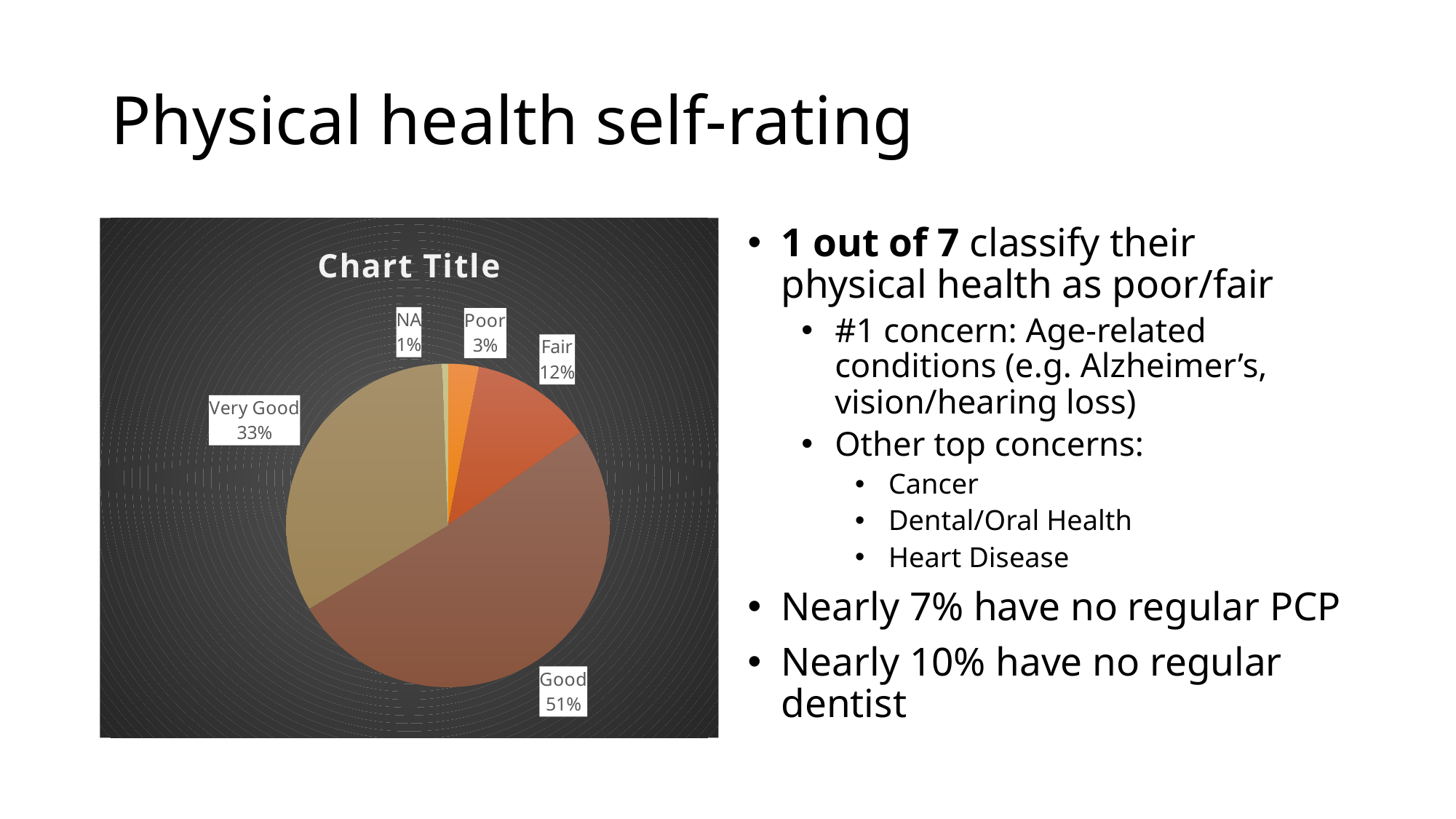
What share of the pie is labelled Good? 51% What is the title shown on the chart? Chart Title What share of the pie is labelled Very Good? 33% Which category has the smallest slice of the pie? NA What share of the pie is labelled NA? 1% Which slice is larger, Fair or Poor? Fair What is the difference in percentage points between the Good and Very Good slices? 18 Which category has the largest slice of the pie? Good What kind of chart is shown on the slide? pie chart How many slices does the pie chart have? 5